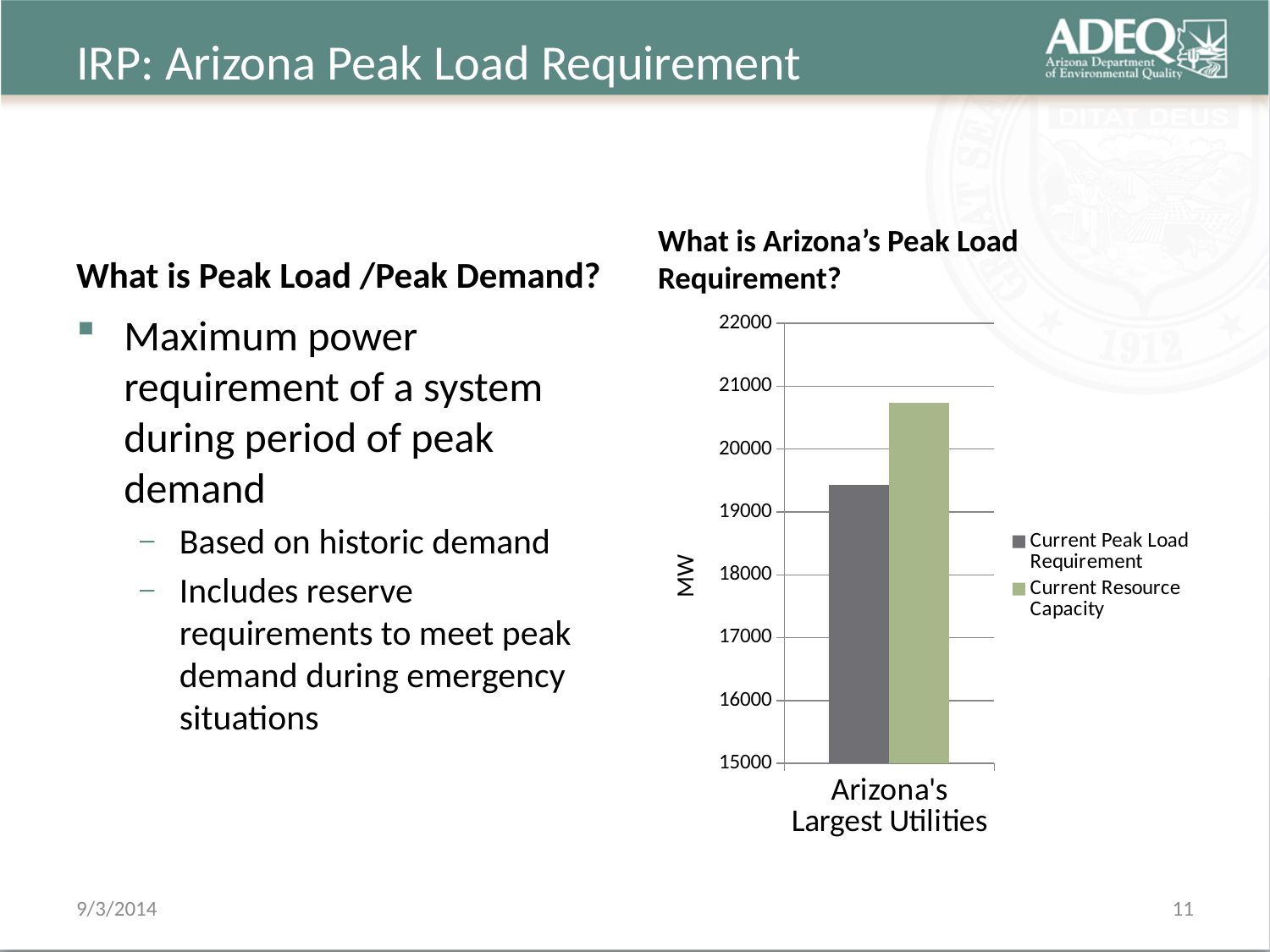
What is the label on the y axis of the chart? MW Is the value for Current Peak Load Requirement greater or less than 20000? less How many series does the chart legend list? 2 Which series has the highest value in the chart? Current Resource Capacity What is the category label on the x axis of the chart? Arizona's Largest Utilities Is the value for Current Resource Capacity greater or less than 21000? less Which series has the lowest value in the chart? Current Peak Load Requirement Is the value for Current Resource Capacity greater or less than 20000? greater What kind of chart is shown on the slide? bar chart How many categories are shown on the x axis of the chart? 1 Which series has the taller bar, Current Peak Load Requirement or Current Resource Capacity? Current Resource Capacity